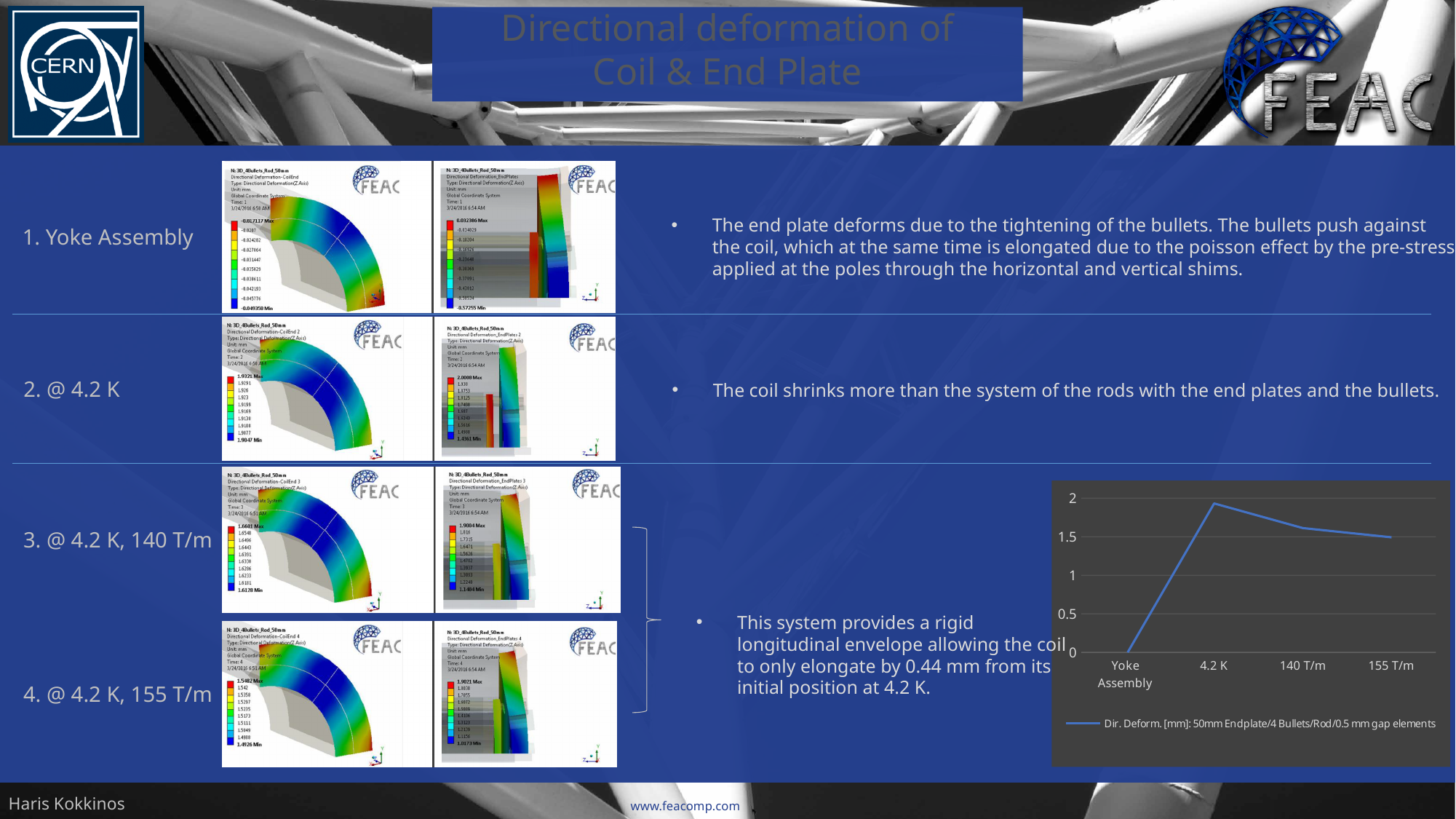
Which category has the lowest value in the line chart? Yoke Assembly In the line chart, do the values rise or fall from 4.2 K to 155 T/m? fall In the line chart, which is larger: the value for 4.2 K or the value for 155 T/m? 4.2 K In the line chart, is the value for 4.2 K greater or less than 1.5? greater How many categories are shown on the x axis of the line chart? 4 How many series does the legend of the line chart list? 1 Which category has the highest value in the line chart? 4.2 K What is the legend entry of the line chart? Dir. Deform. [mm]: 50mm Endplate/4 Bullets/Rod/0.5 mm gap elements In the line chart, is the value for Yoke Assembly greater or less than 0.5? less What kind of chart is shown at the bottom right of the slide? line chart In the line chart, is the value for 155 T/m greater or less than 1? greater In the line chart, which is larger: the value for 140 T/m or the value for 155 T/m? 140 T/m